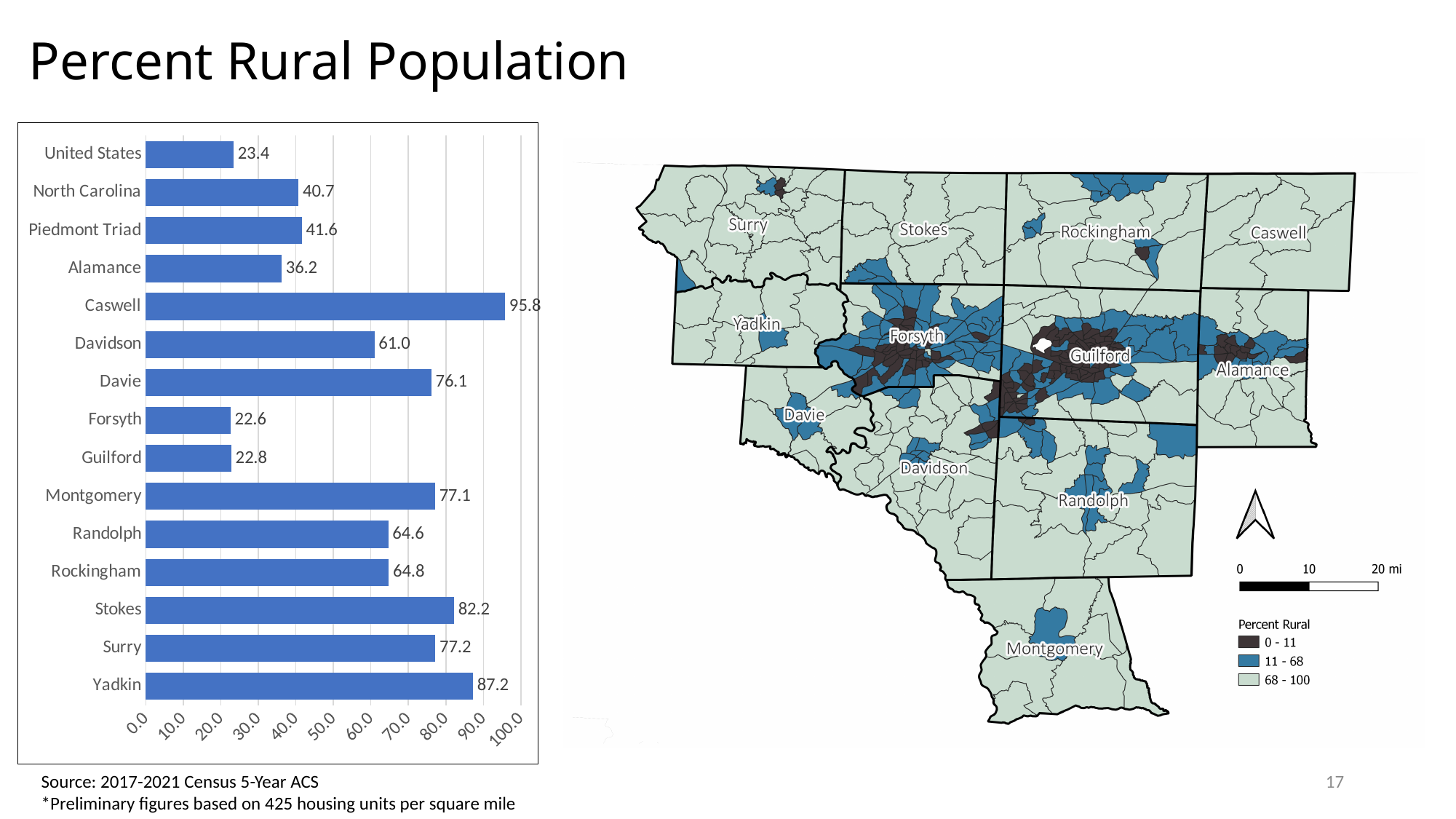
What kind of chart is shown on the left of the slide? bar chart Which category has the lowest percent rural population? Forsyth What is the title of the slide containing the chart? Percent Rural Population Is the value for Montgomery greater or less than 70.0? greater Which category has the highest percent rural population? Caswell What is the difference between the values for Guilford and Forsyth? 0.2 What is the percent rural population value for Piedmont Triad? 41.6 How many categories are shown in the bar chart? 15 What is the difference between the values for Yadkin and North Carolina? 46.5 Which has a larger percent rural population, Stokes or Davidson? Stokes What is the percent rural population value for the United States? 23.4 What is the percent rural population value for Caswell? 95.8